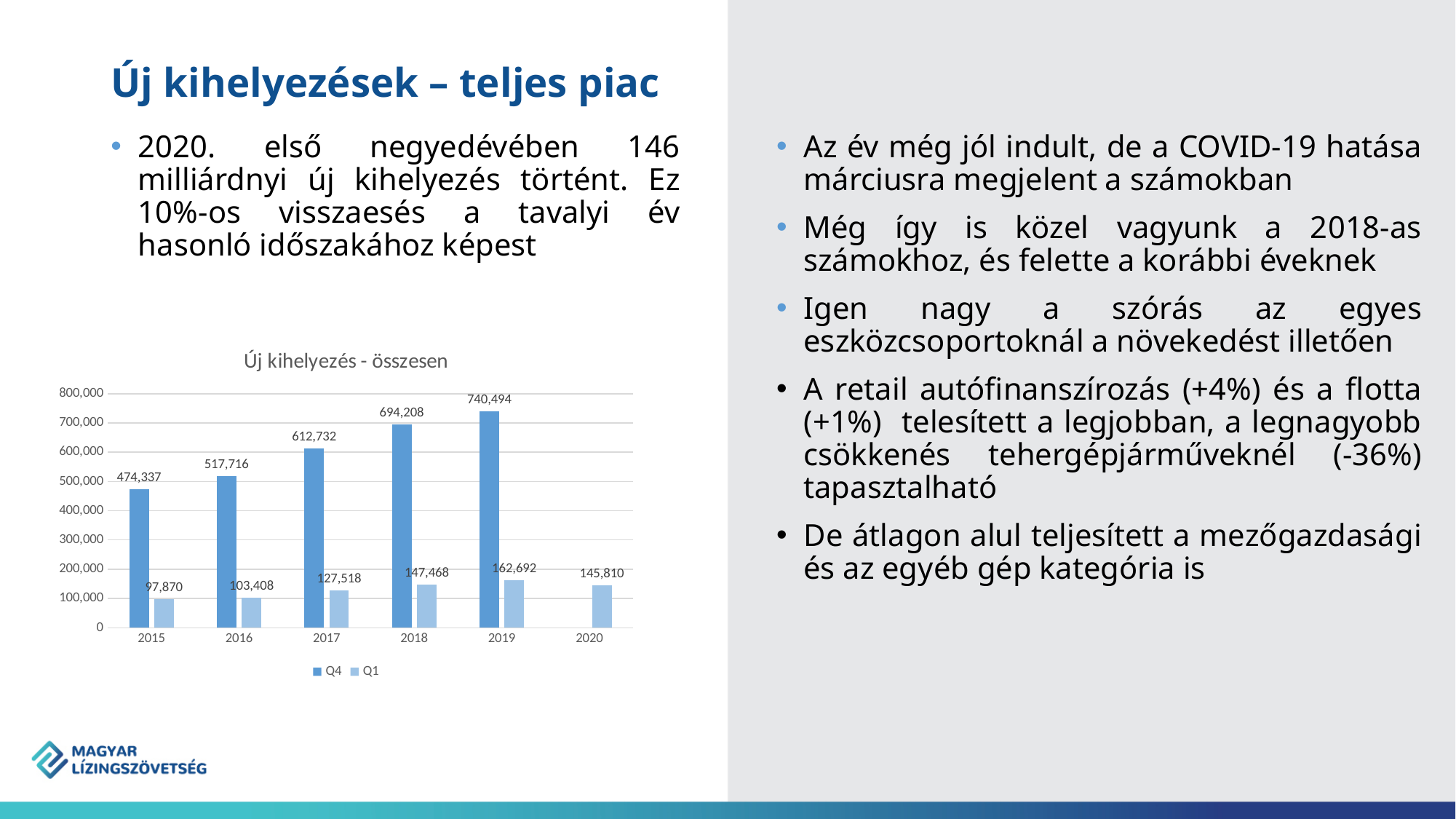
How many series does the chart legend list? 2 Which is larger, the Q1 value for 2018 or the Q1 value for 2020? 2018 Which year has the highest Q4 value in the chart? 2019 What is the title of the chart? Új kihelyezés - összesen Is the Q4 value for 2018 greater or less than 600,000? greater What kind of chart is shown on the slide? bar chart What is the difference between the Q1 values for 2019 and 2020? 16,882 What is the Q1 value for 2020 in the chart? 145,810 How many years are shown on the x axis of the chart? 6 What is the Q4 value for 2015 in the chart? 474,337 What is the Q4 value for 2017 in the chart? 612,732 Which year has the lowest Q1 value in the chart? 2015